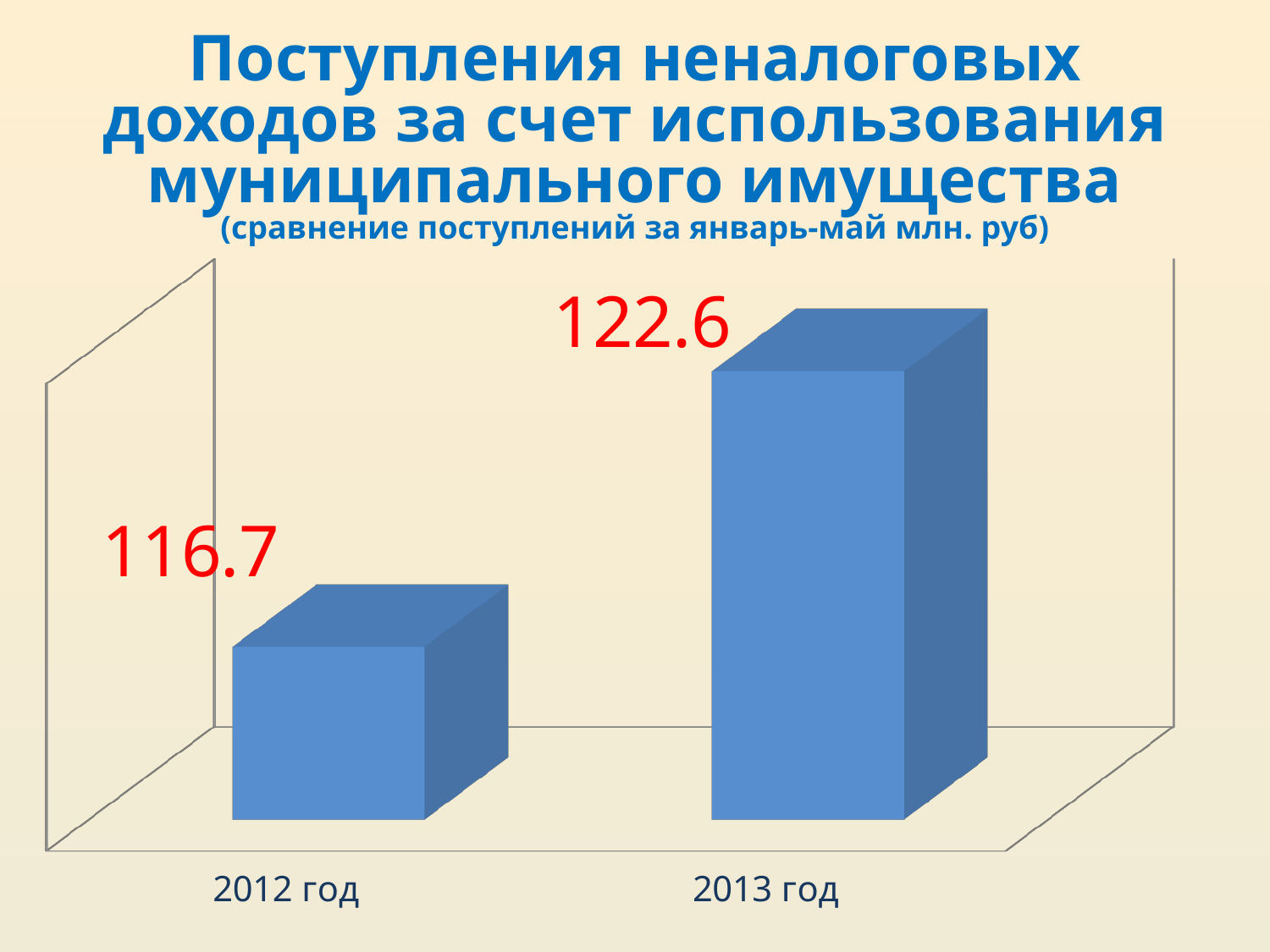
Do the values rise or fall from 2012 год to 2013 год? rise How many categories are shown on the chart? 2 What is the value for 2013 год? 122.6 What is the value for 2012 год? 116.7 Which year has the lowest value? 2012 год What unit is stated in the chart subtitle for the values? млн. руб Which is larger, the value for 2012 год or the value for 2013 год? 2013 год What is the total of the two values shown on the chart? 239.3 What colour are the bars on the chart? blue What is the difference between the values for 2013 год and 2012 год? 5.9 Which year has the highest value? 2013 год What kind of chart is shown on the slide? bar chart